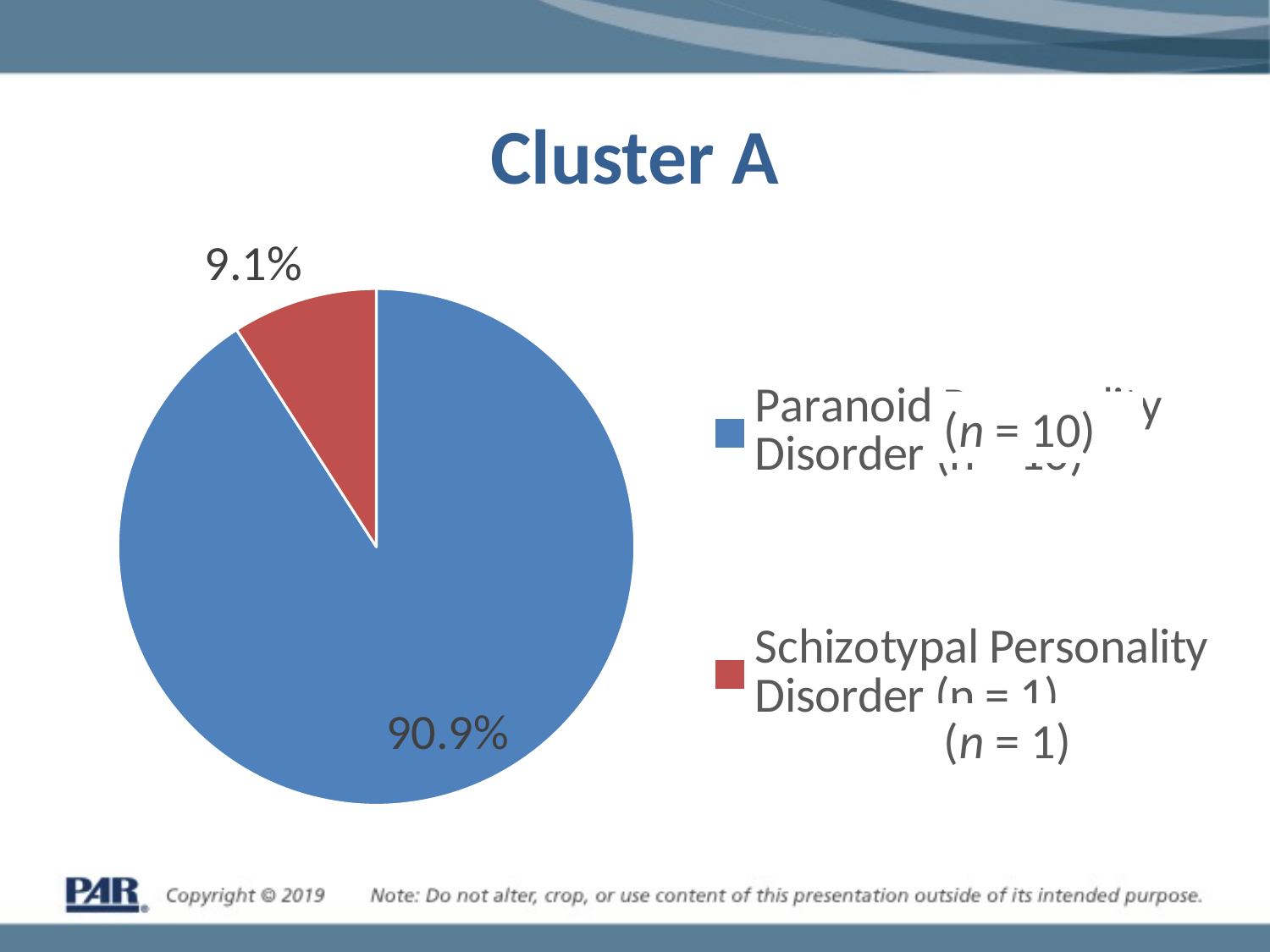
Which category has the largest slice of the pie? Paranoid Personality Disorder Which slice is larger, Paranoid Personality Disorder or Schizotypal Personality Disorder? Paranoid Personality Disorder What colour is the Schizotypal Personality Disorder slice? Red What is the sample size (n) shown in the legend for Paranoid Personality Disorder? 10 Which category has the smallest slice of the pie? Schizotypal Personality Disorder What is the difference in percentage points between the Paranoid Personality Disorder slice and the Schizotypal Personality Disorder slice? 81.8% What type of chart is shown on the slide? Pie chart What share of the pie does Paranoid Personality Disorder represent? 90.9% How many entries does the legend list? 2 How many slices does the pie chart have? 2 What is the title of the chart? Cluster A What share of the pie does Schizotypal Personality Disorder represent? 9.1%